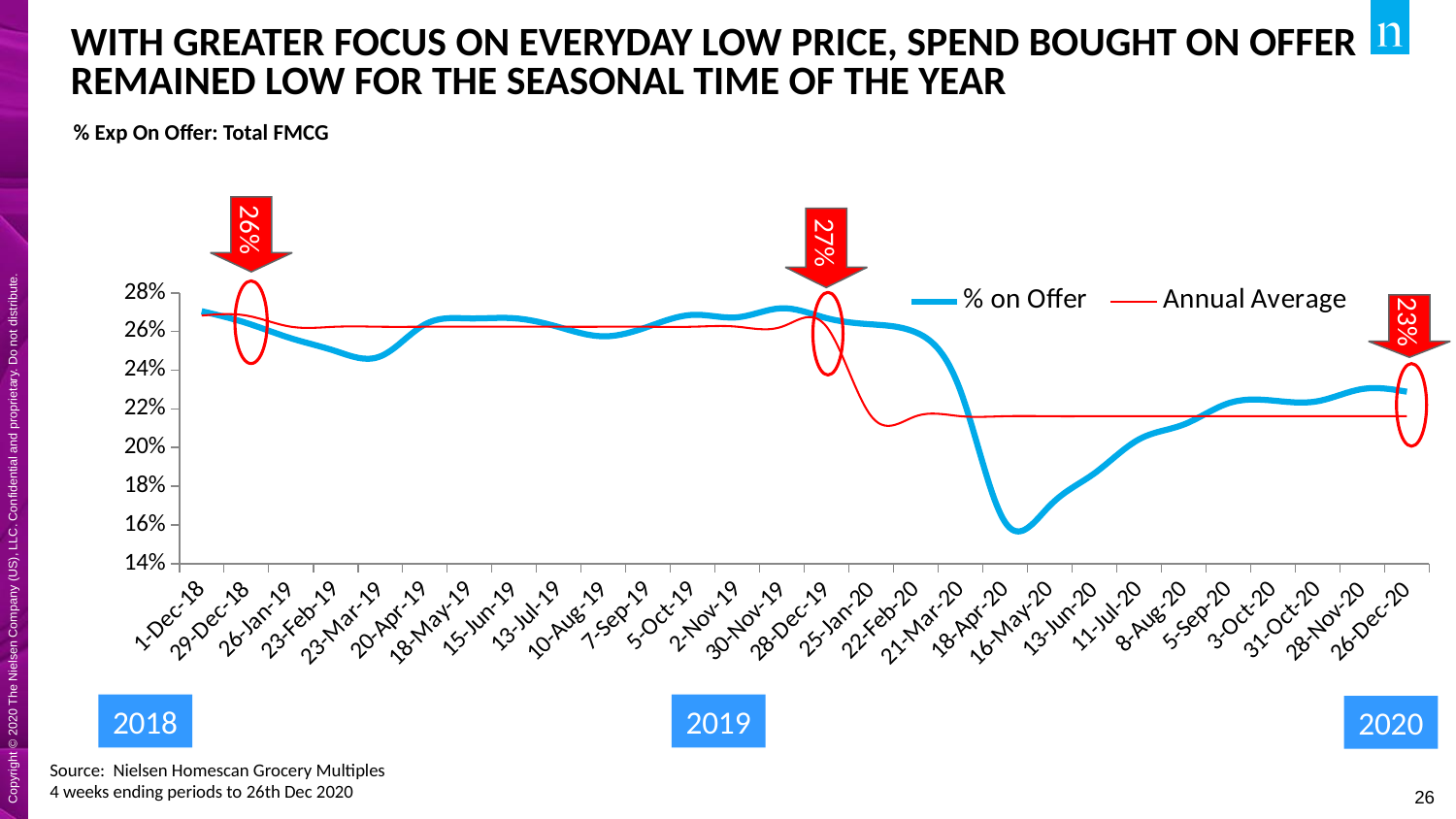
What value is annotated for % on Offer at 26-Dec-20? 23% How many series does the legend list? 2 What are the two series named in the legend? % on Offer and Annual Average Does the % on Offer line rise or fall between 16-May-20 and 26-Dec-20? Rise What kind of chart is shown on the slide? Line chart Is the % on Offer value at 16-May-20 greater or less than 18%? less Which is larger, the annotated % on Offer at 28-Dec-19 or at 26-Dec-20? 28-Dec-19 What is the difference between the annotated % on Offer values at 28-Dec-19 and 26-Dec-20? 4 percentage points At which x-axis date does the % on Offer line reach its lowest point? 18-Apr-20 What value is annotated for % on Offer at 28-Dec-19? 27% How many dates are labelled on the x axis? 28 What value is annotated for % on Offer at 29-Dec-18? 26%